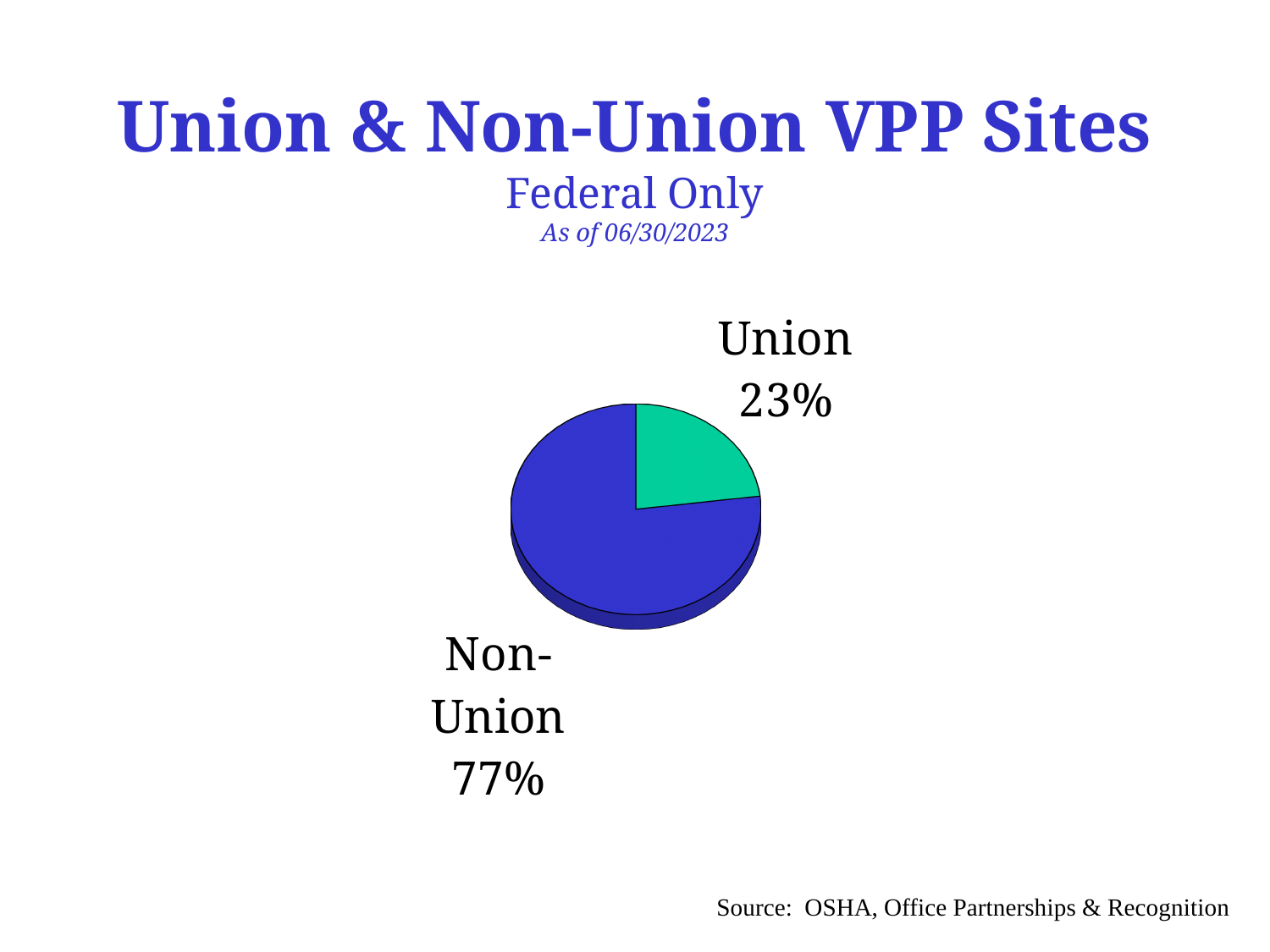
What share of the pie is labelled Union? 23% What is the title of the chart on the slide? Union & Non-Union VPP Sites Which category has the smallest share of the pie? Union How many slices does the pie chart have? 2 Which is larger, the Union share or the Non-Union share? Non-Union What is the total of the two slice percentages shown? 100% Which category has the largest share of the pie? Non-Union What colour is the Union slice of the pie? Green What is the difference in percentage points between the Non-Union and Union shares? 54 What share of the pie is labelled Non-Union? 77% What kind of chart is shown on the slide? Pie chart